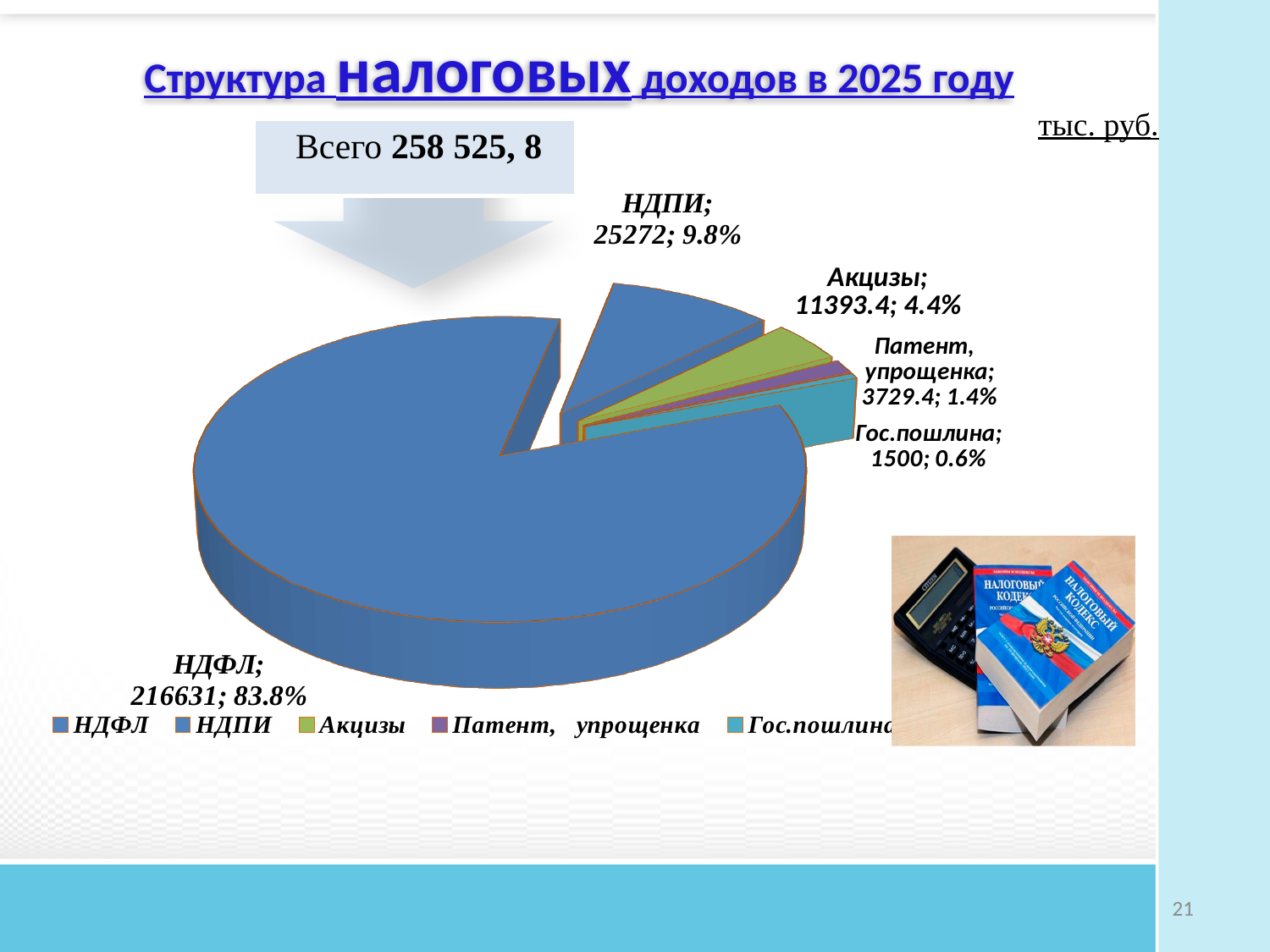
What share of the pie does НДПИ represent? 9.8% Which category has the smallest slice of the pie? Гос.пошлина How many categories does the pie chart have? 5 Which category has the largest slice of the pie? НДФЛ What is the title of the slide containing the chart? Структура налоговых доходов в 2025 году What is the value for НДФЛ? 216631 What is the value for Гос.пошлина? 1500 Which is larger, the value for Акцизы or the value for Патент, упрощенка? Акцизы What is the difference between the values for НДПИ and Акцизы? 13878.6 What kind of chart is shown on the slide? Pie chart What is the value for Акцизы? 11393.4 What share of the pie does Патент, упрощенка represent? 1.4%